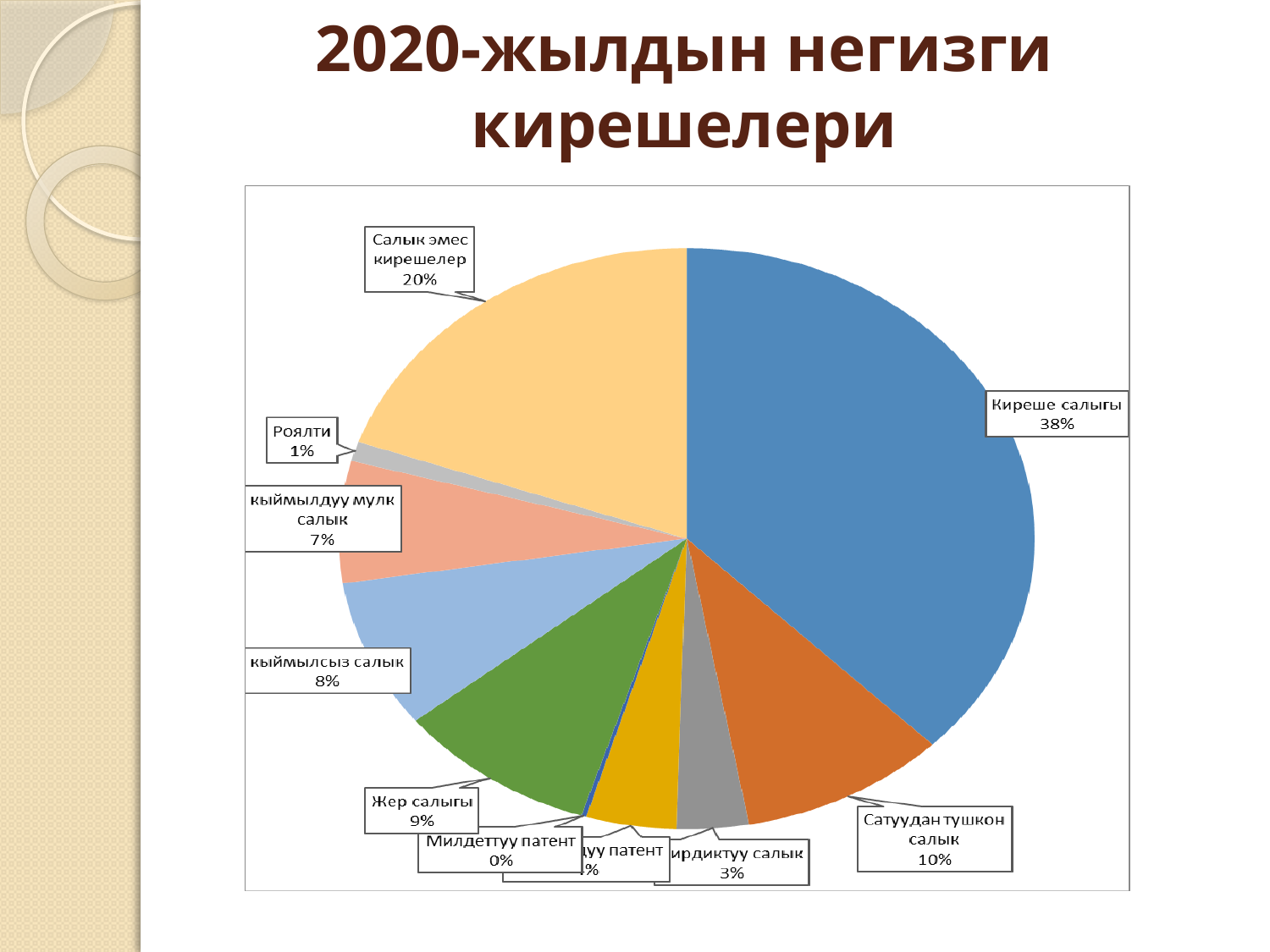
What share of the pie does Киреше салыгы represent? 38% Which category has the largest share of the pie? Киреше салыгы Which is larger, the share for кыймылсыз салык or the share for Жер салыгы? Жер салыгы What is the difference in percentage points between Киреше салыгы and Салык эмес кирешелер? 18 What percentage is shown for кыймылдуу мулк салык? 7% What percentage is shown for Салык эмес кирешелер? 20% Which category has the smallest share of the pie? Милдеттуу патент What percentage is shown for Роялти? 1% What is the title of the chart on the slide? 2020-жылдын негизги кирешелери What percentage is shown for Жер салыгы? 9% What percentage is shown for Сатуудан тушкон салык? 10% What kind of chart is shown on the slide? pie chart